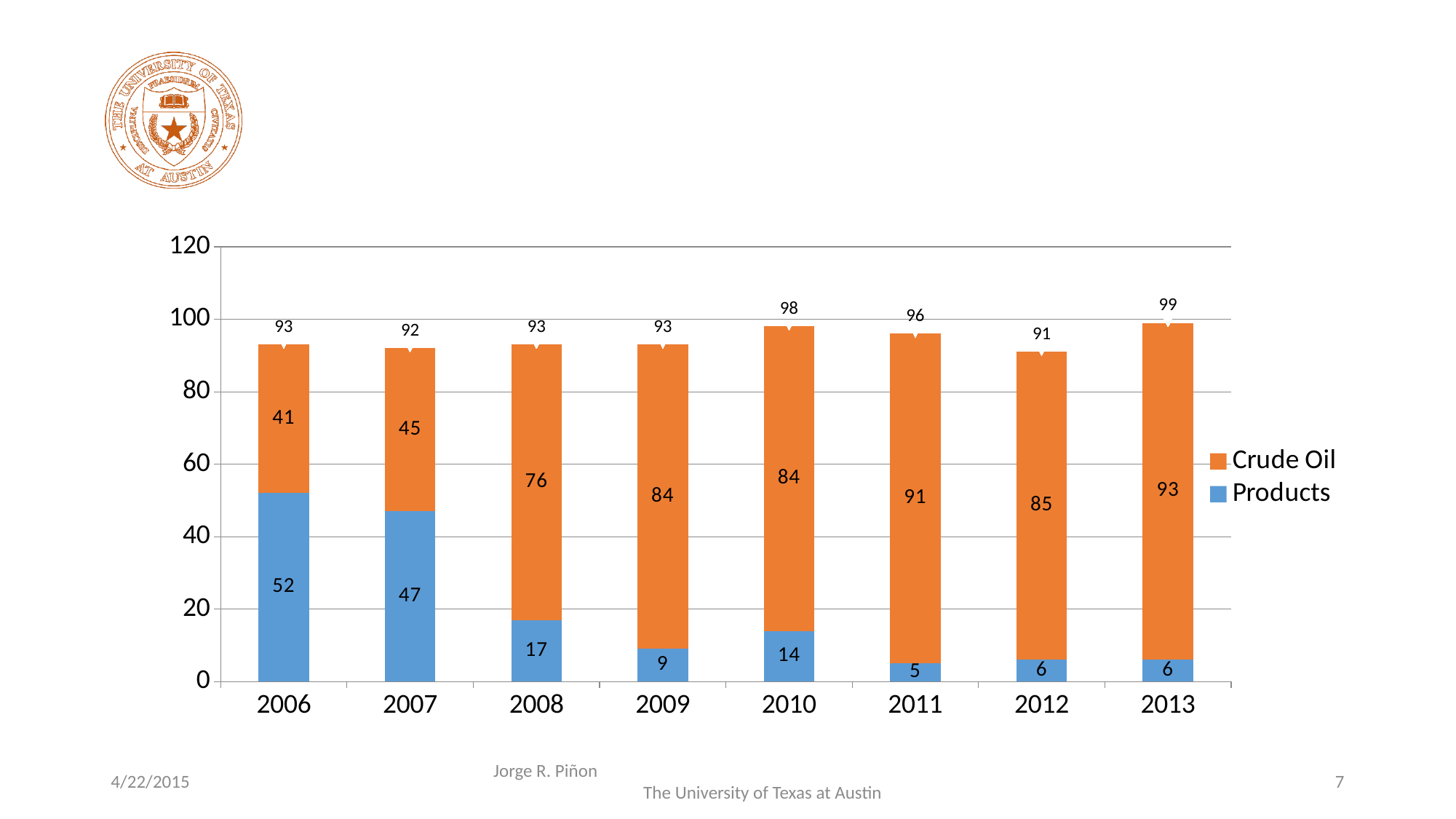
What is the difference between the Crude Oil values for 2013 and 2006? 52 Which year has the highest Products value? 2006 What is the total of the stacked bar for 2012? 91 What is the total of the stacked bar for 2013? 99 How many series does the legend list? 2 How many years are shown on the x axis? 8 Which year has the highest stacked total? 2013 What is the Products value for 2006? 52 What is the Crude Oil value for 2011? 91 Which year has the lowest Products value? 2011 What kind of chart is shown on the slide? Stacked bar chart Which is larger, the Crude Oil value for 2008 or the Crude Oil value for 2009? 2009